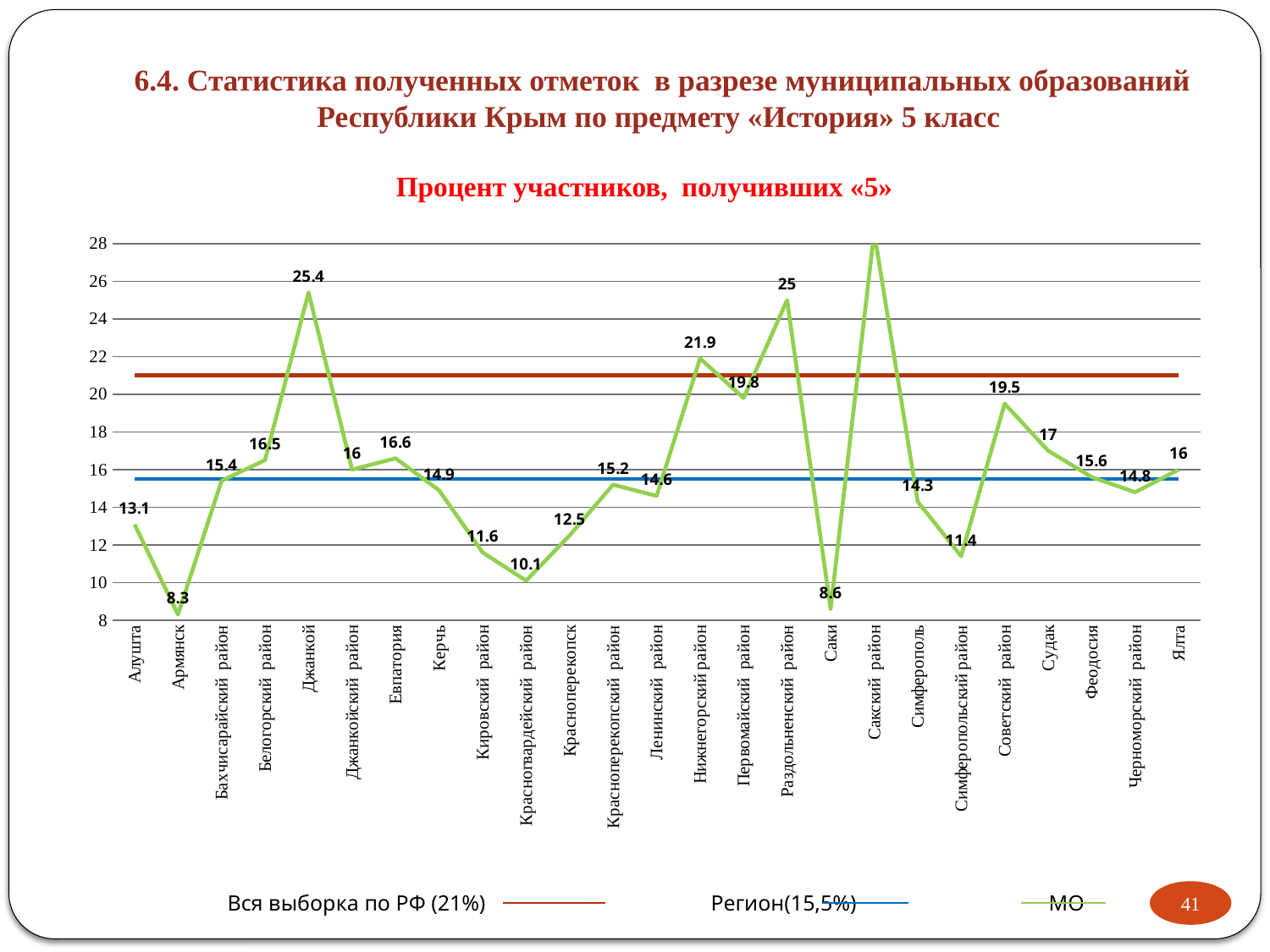
Which municipality has the lowest value on the МО line? Армянск What is the value for Армянск? 8.3 Which municipality has the highest value on the МО line? Сакский район How many series does the legend list? 3 How many municipalities are plotted along the x axis? 25 What is the value for Нижнегорский район? 21.9 What is the value for Симферопольский район? 11.4 What type of chart is shown on the slide? line chart Which is larger, the value for Советский район or the value for Судак? Советский район What is the difference between the values for Раздольненский район and Саки? 16.4 Is the value for Сакский район greater or less than 26? greater What is the value for Джанкой? 25.4